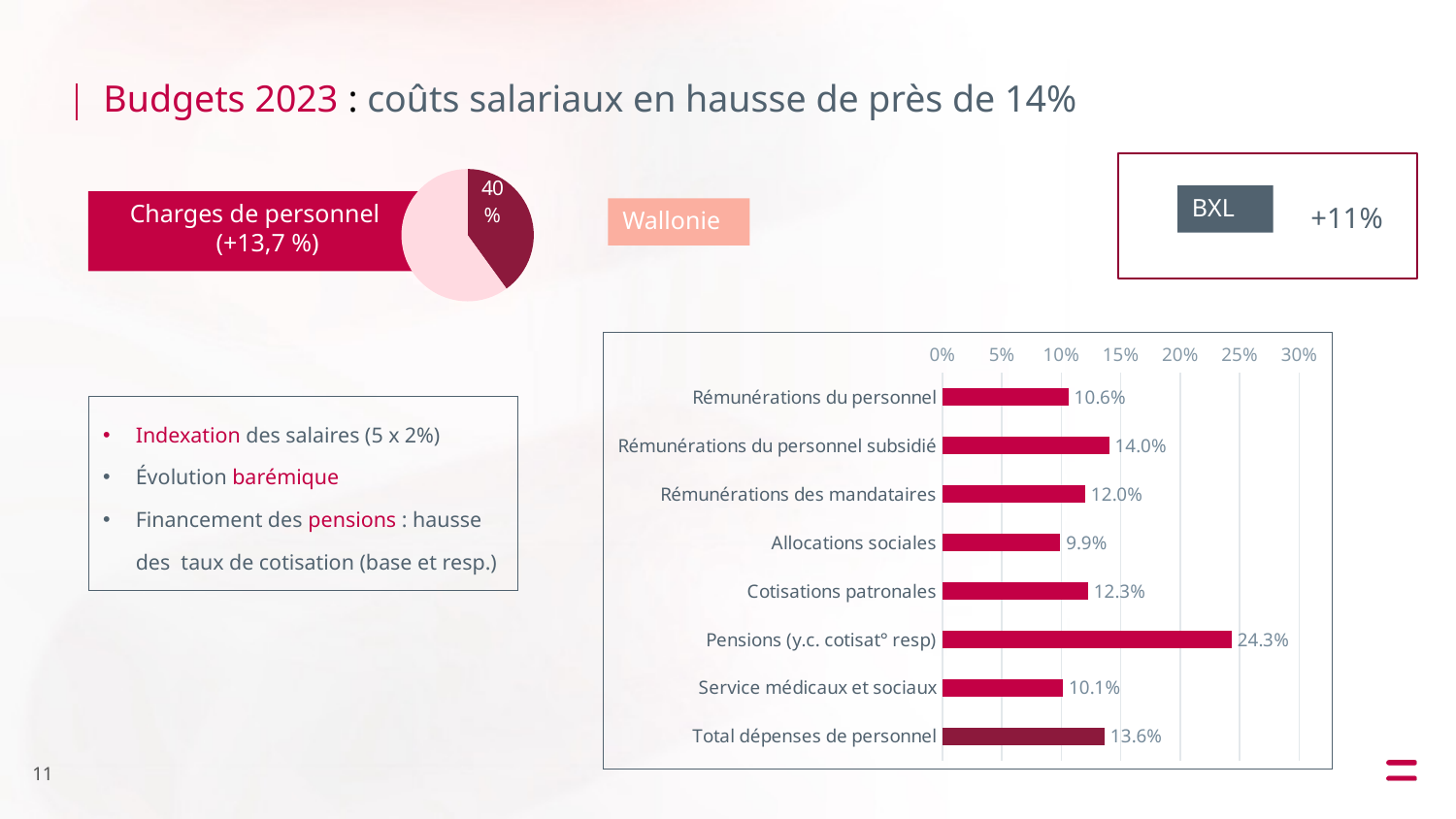
In the bar chart on the right, what is the difference between Pensions (y.c. cotisat° resp) and Rémunérations du personnel? 13.7% In the bar chart on the right, what is the value for Pensions (y.c. cotisat° resp)? 24.3% In the bar chart on the right, is the value for Pensions (y.c. cotisat° resp) greater or less than 20%? greater In the pie chart at the top left, what share is shown by the labeled slice? 40% In the bar chart on the right, what is the value for Total dépenses de personnel? 13.6% In the bar chart on the right, what is the value for Allocations sociales? 9.9% What kind of chart is shown on the right side of the slide? bar chart How many categories are shown in the bar chart on the right? 8 In the bar chart on the right, which category has the lowest value? Allocations sociales In the bar chart on the right, what is the value for Rémunérations du personnel subsidié? 14.0% In the bar chart on the right, which is larger: Cotisations patronales or Rémunérations des mandataires? Cotisations patronales In the bar chart on the right, which category has the highest value? Pensions (y.c. cotisat° resp)